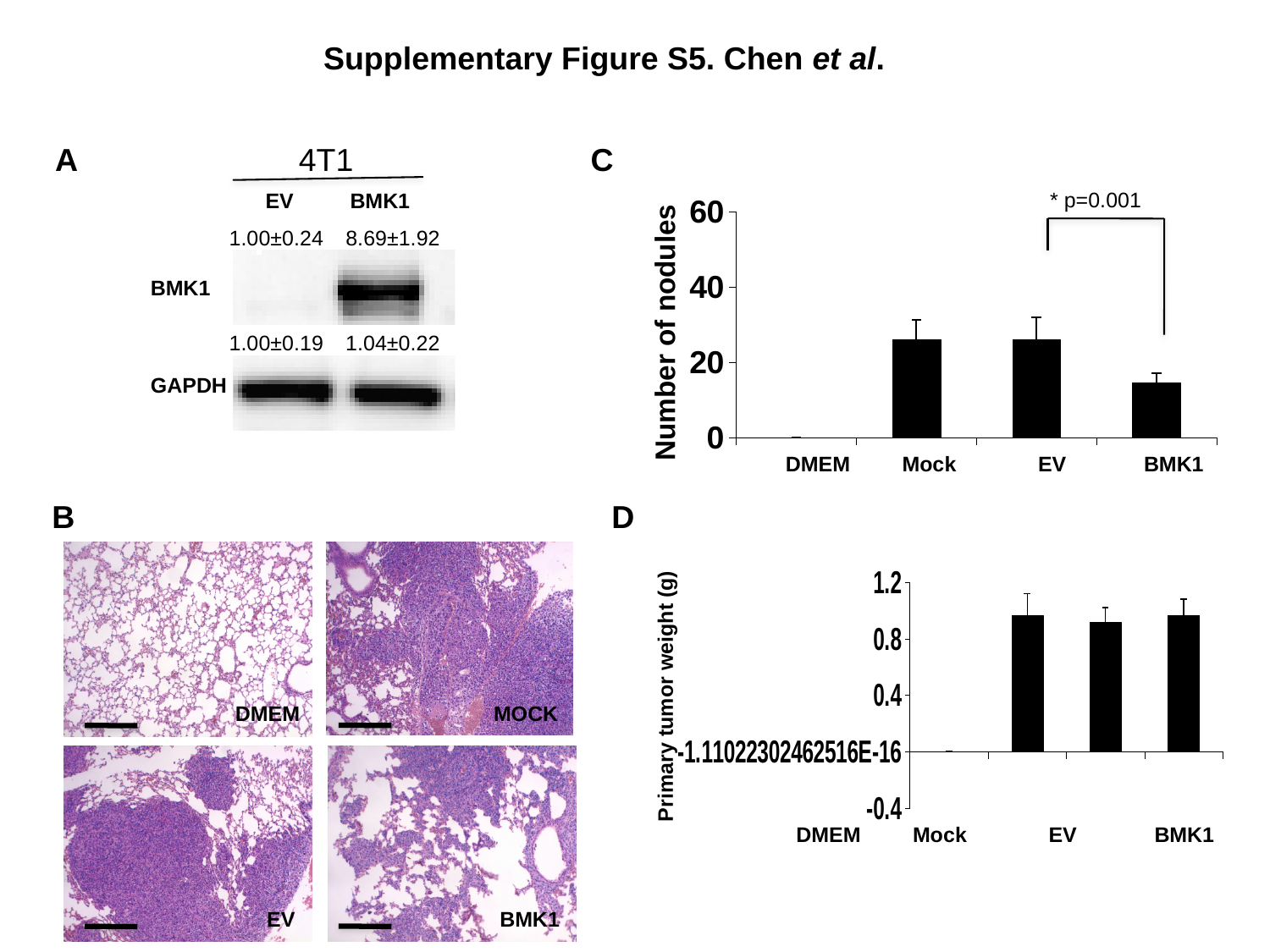
How many categories are shown on the x axis of panel C (Number of nodules)? 4 What is the y-axis title of panel D? Primary tumor weight (g) In panel D (Primary tumor weight), is the value for EV greater or less than 0.8? greater What p-value is annotated between EV and BMK1 in panel C (Number of nodules)? p=0.001 In panel C (Number of nodules), is the value for BMK1 greater or less than 20? less In panel C (Number of nodules), is the value for Mock greater or less than 20? greater What kind of chart is panel C (Number of nodules)? bar chart In panel C (Number of nodules), which is larger, the value for EV or the value for BMK1? EV In panel C (Number of nodules), which category has the lowest value? DMEM How many categories are shown on the x axis of panel D (Primary tumor weight)? 4